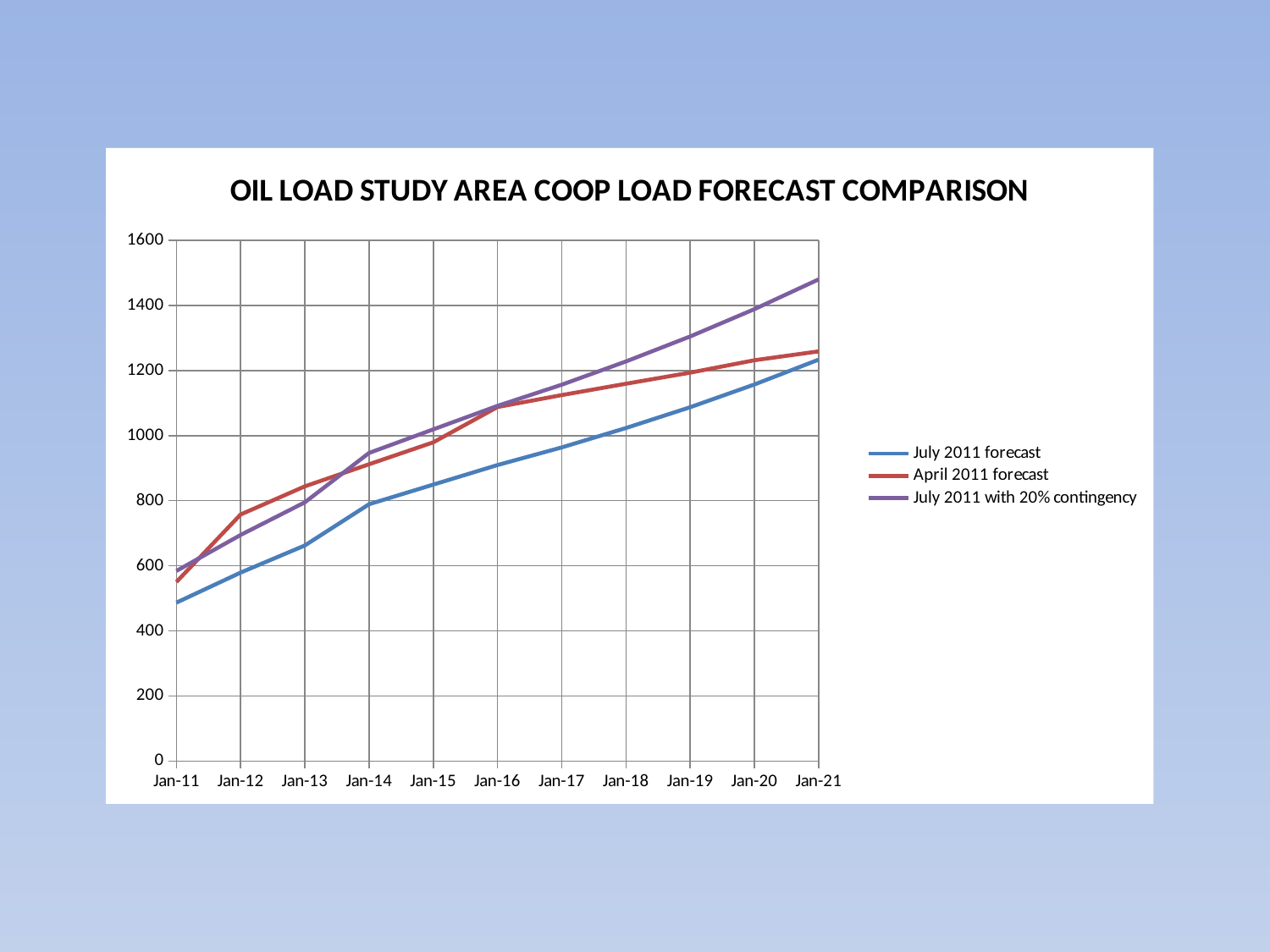
Which series has the highest value at Jan-21? July 2011 with 20% contingency What kind of chart is shown on the slide? Line chart How many points are plotted along the x axis for each series? 11 Is the value for July 2011 with 20% contingency at Jan-21 greater or less than 1400? greater Is the value for the July 2011 forecast at Jan-11 greater or less than 600? less How many series does the legend list? 3 What is the title of the chart? OIL LOAD STUDY AREA COOP LOAD FORECAST COMPARISON Which series has the lowest value at Jan-21? July 2011 forecast Is the value for the July 2011 forecast at Jan-14 greater or less than 1000? less At Jan-20, which is larger: the July 2011 with 20% contingency or the April 2011 forecast? July 2011 with 20% contingency At Jan-12, which is larger: the April 2011 forecast or the July 2011 forecast? April 2011 forecast Do the values of the July 2011 forecast rise or fall from Jan-11 to Jan-21? Rise